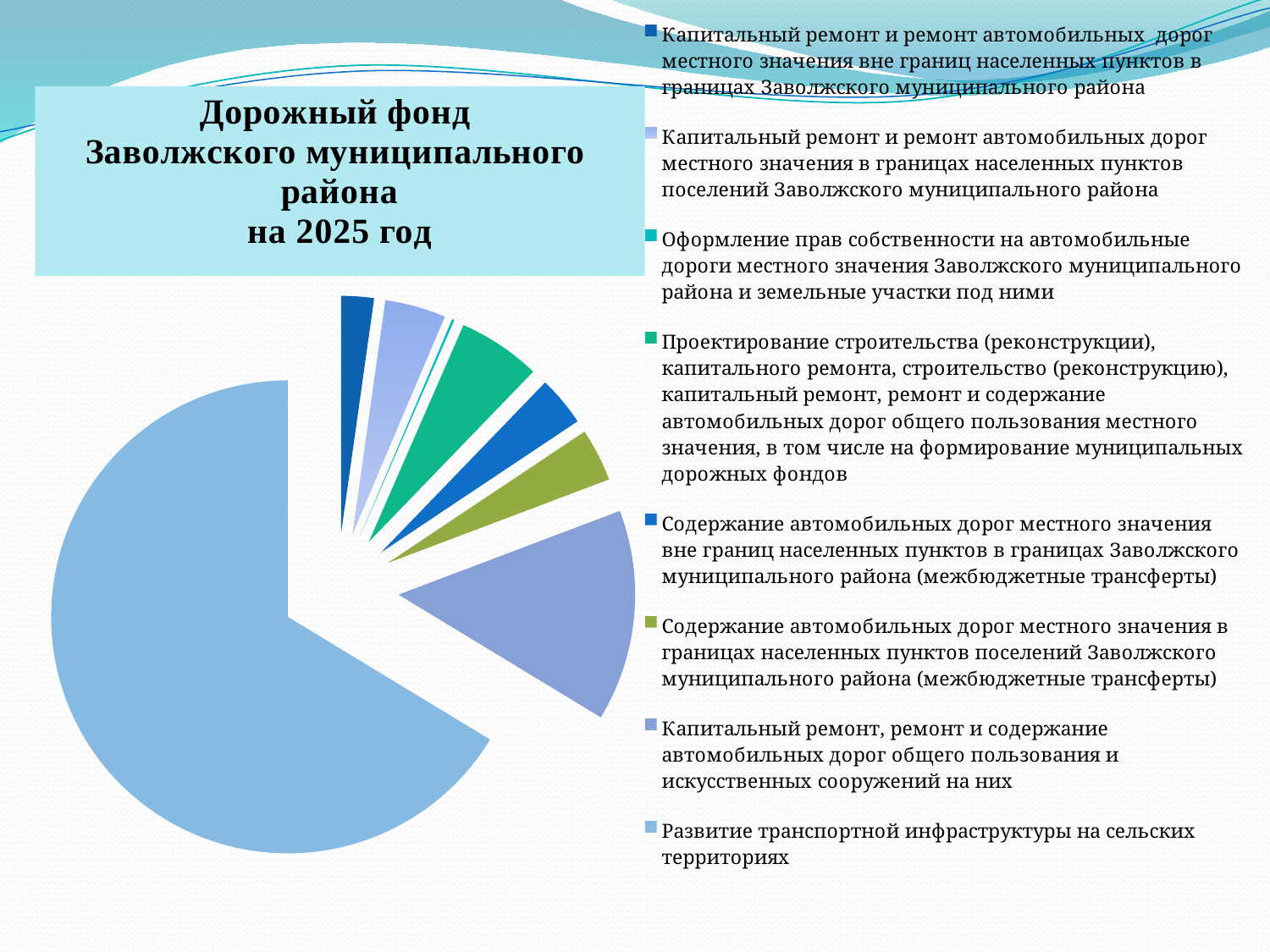
How many slices does the pie chart have? 8 What colour is the largest slice of the pie chart? light blue Which slice is larger: "Капитальный ремонт, ремонт и содержание автомобильных дорог общего пользования и искусственных сооружений на них" or "Содержание автомобильных дорог местного значения в границах населенных пунктов поселений Заволжского муниципального района (межбюджетные трансферты)"? Капитальный ремонт, ремонт и содержание автомобильных дорог общего пользования и искусственных сооружений на них Does the largest slice of the pie chart take up more or less than half of the pie? more Which category has the largest slice of the pie chart? Развитие транспортной инфраструктуры на сельских территориях Which category has the smallest slice of the pie chart? Оформление прав собственности на автомобильные дороги местного значения Заволжского муниципального района и земельные участки под ними How many entries does the legend of the pie chart list? 8 What is the title of the chart on the slide? Дорожный фонд Заволжского муниципального района на 2025 год Which slice is larger: "Развитие транспортной инфраструктуры на сельских территориях" or "Капитальный ремонт, ремонт и содержание автомобильных дорог общего пользования и искусственных сооружений на них"? Развитие транспортной инфраструктуры на сельских территориях What kind of chart is shown on the slide? pie chart